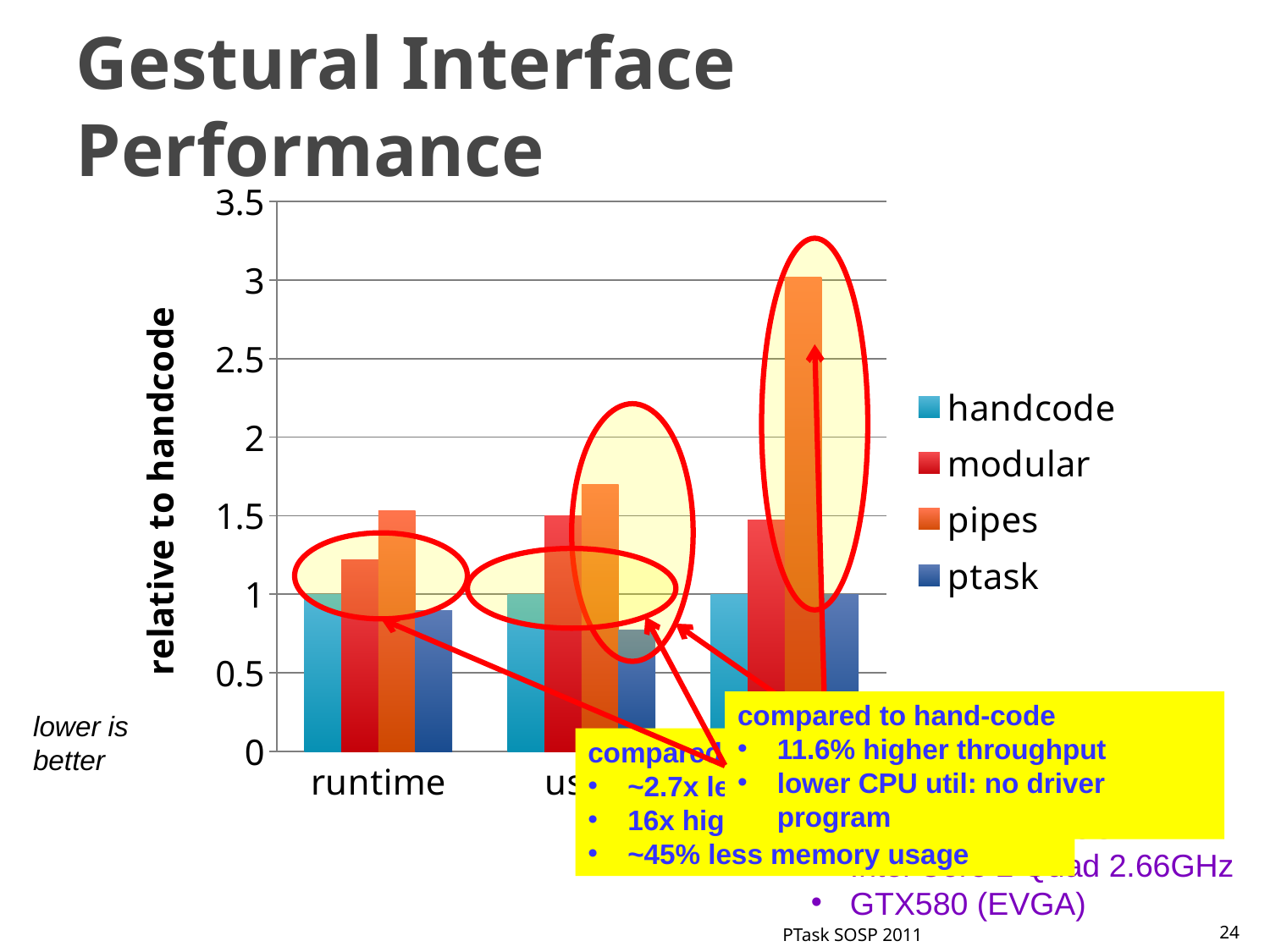
What kind of chart is shown on the slide? bar chart Which series has the tallest bar anywhere in the chart? pipes For the runtime category, which is larger: modular or pipes? pipes How many series does the chart legend list? 4 How many category groups of bars are plotted in the chart? 3 Is the value of pipes for the runtime category greater or less than 2? less What is the value of handcode for the runtime category? 1 What is the highest tick value shown on the vertical axis? 3.5 What is the title of the vertical axis of the chart? relative to handcode Is the value of modular for the runtime category greater or less than 1? greater Which series has the highest bar in the runtime category? pipes What are the series names listed in the chart legend? handcode, modular, pipes, ptask